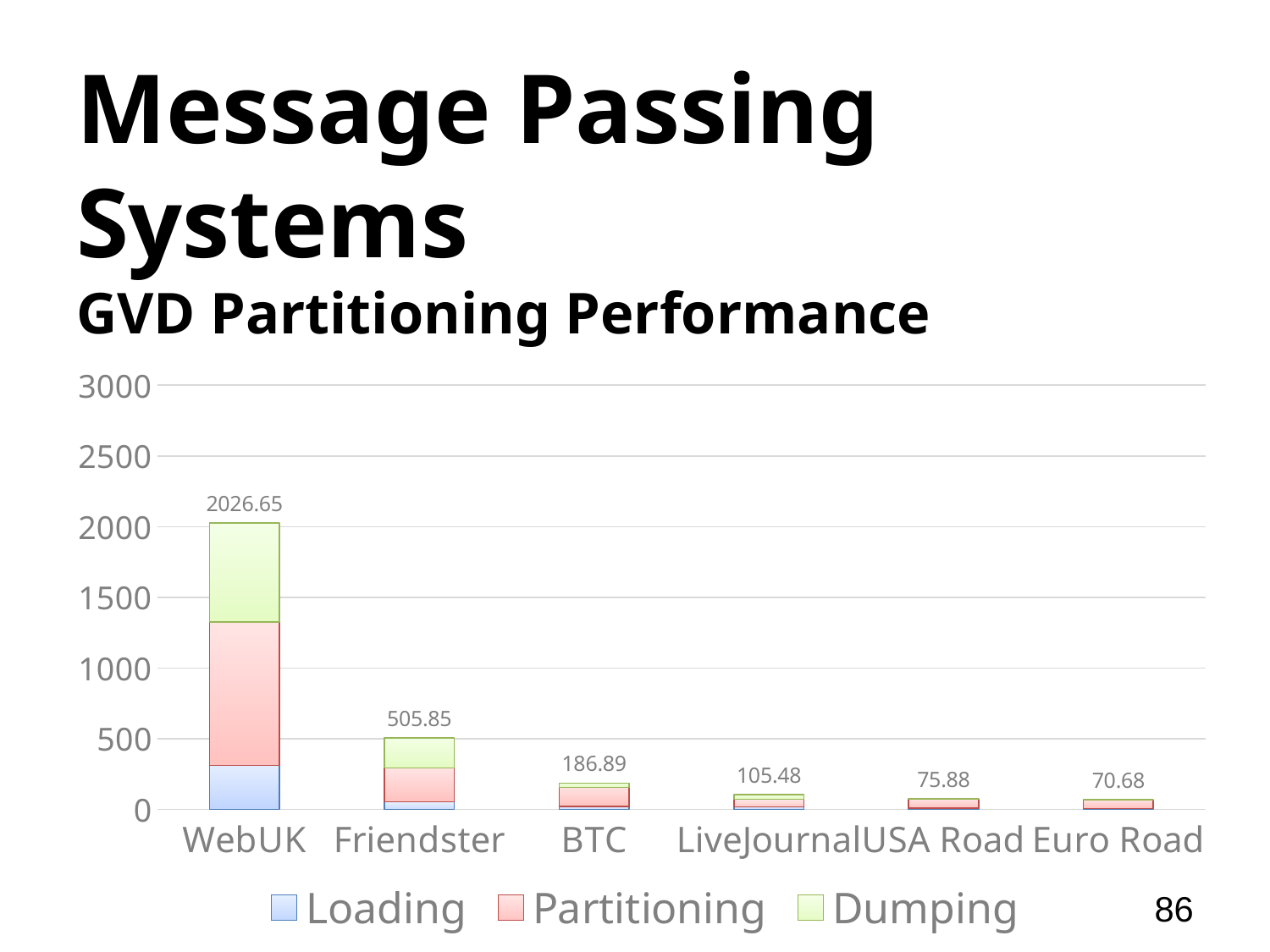
What is the total value shown for Friendster? 505.85 Which category has the highest total? WebUK What is the total value shown for WebUK? 2026.65 What kind of chart is shown on the slide? stacked bar chart How many series does the legend list? 3 How many categories are shown on the x axis? 6 What is the total value shown for LiveJournal? 105.48 What is the total value shown for Euro Road? 70.68 Which category has the lowest total? Euro Road Which has a larger total, BTC or LiveJournal? BTC What is the difference between the totals for WebUK and Friendster? 1520.80 Is the total for Friendster greater or less than 500? greater